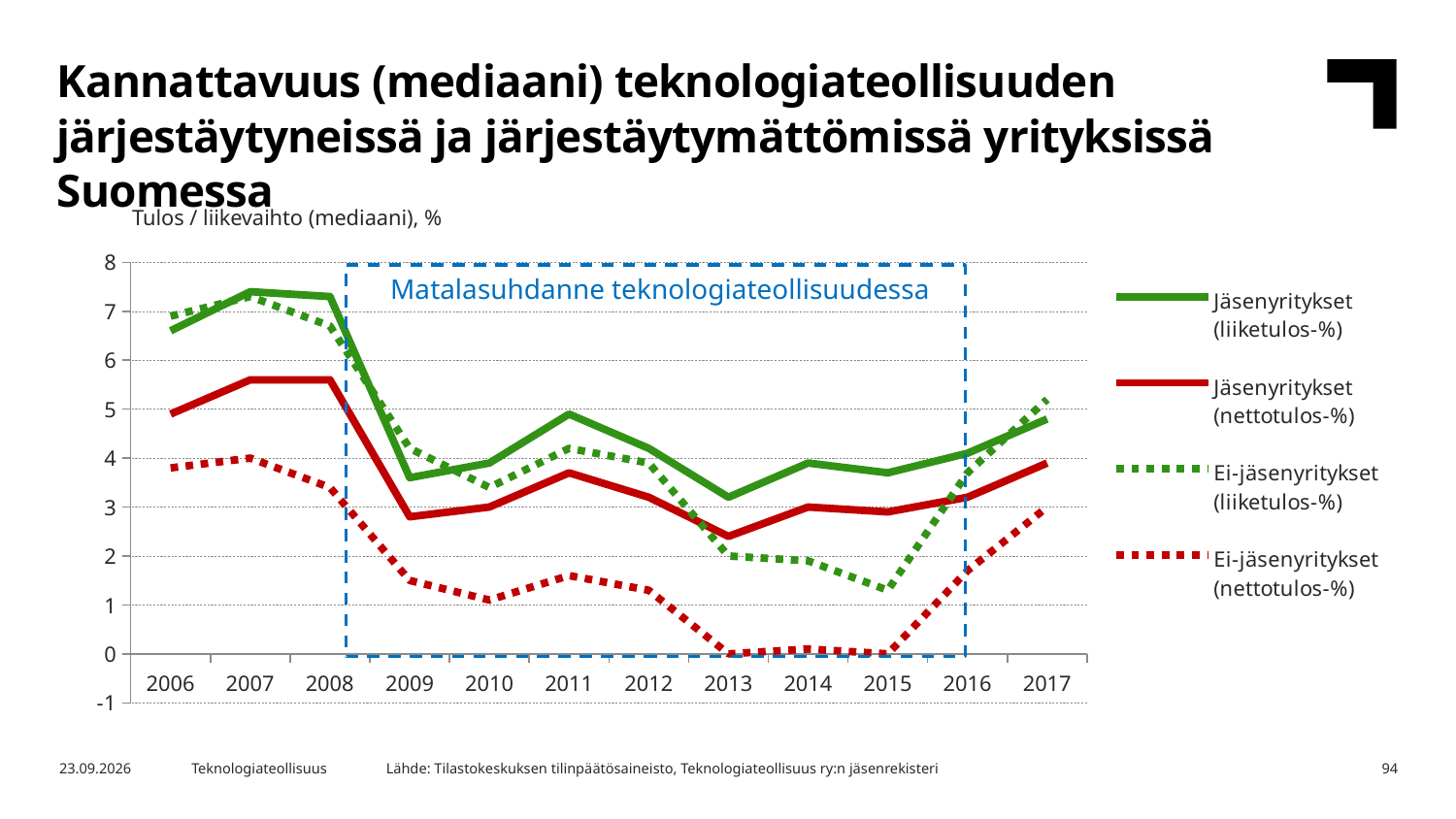
Is the value for Jäsenyritykset (liiketulos-%) in 2007 greater or less than 7? greater In which year is Ei-jäsenyritykset (liiketulos-%) at its lowest? 2015 How many series does the legend list? 4 Is the value for Ei-jäsenyritykset (nettotulos-%) in 2010 greater or less than 2? less Is the value for Ei-jäsenyritykset (liiketulos-%) in 2015 greater or less than 2? less What label is written inside the dashed box on the chart? Matalasuhdanne teknologiateollisuudessa Does Ei-jäsenyritykset (nettotulos-%) rise or fall from 2015 to 2017? Rise Does Jäsenyritykset (liiketulos-%) rise or fall from 2008 to 2009? Fall How many years are shown on the x axis? 12 In 2015, which is larger: Jäsenyritykset (nettotulos-%) or Ei-jäsenyritykset (nettotulos-%)? Jäsenyritykset (nettotulos-%) What kind of chart is shown on the slide? Line chart